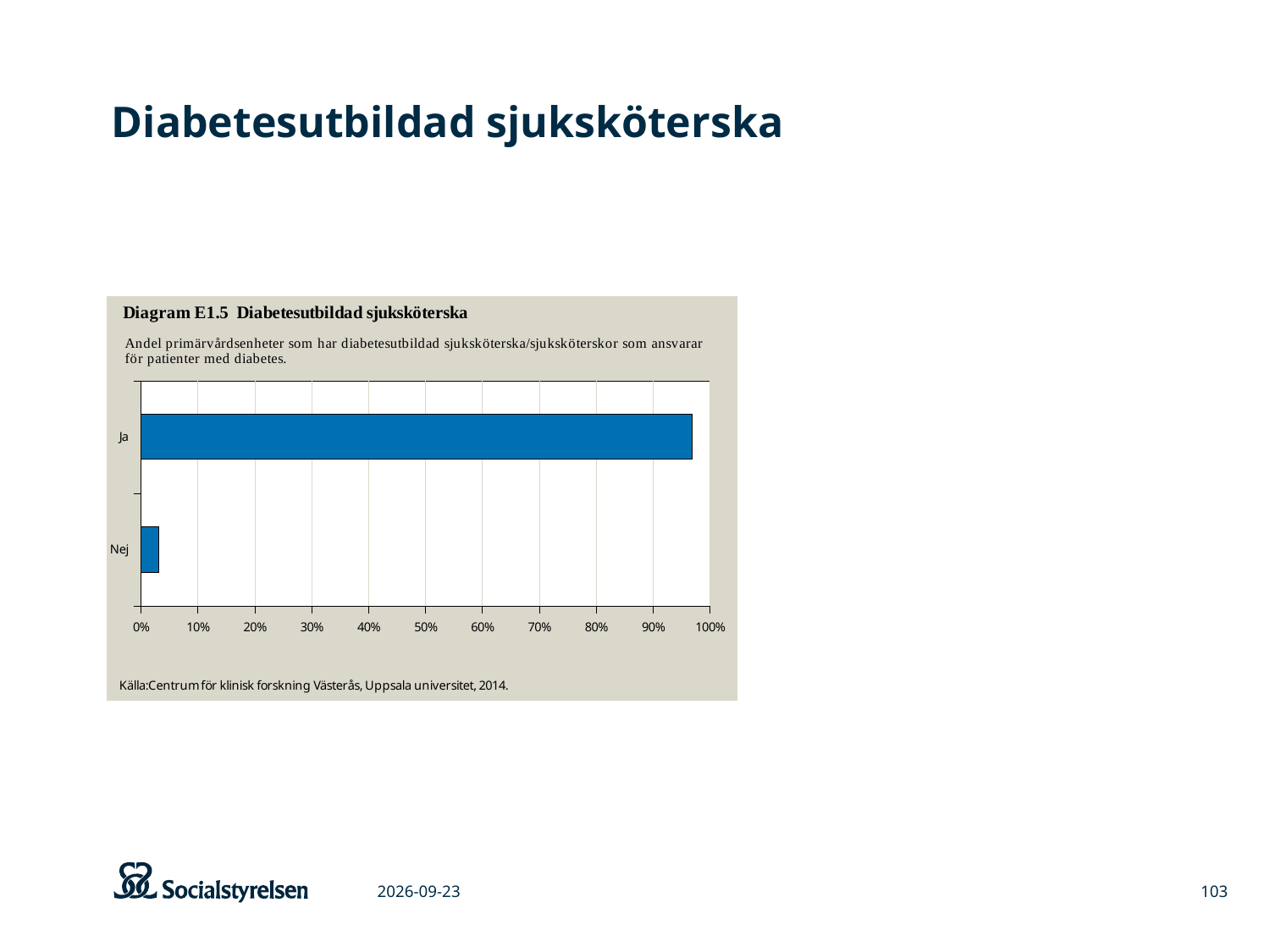
Which is larger, the value for Ja or the value for Nej? Ja How many categories are plotted in the chart? 2 Which category has the lowest value in the chart? Nej What kind of chart is shown in Diagram E1.5? bar chart Is the value for Ja greater or less than 90%? greater Which category has the highest value in the chart? Ja What is the highest value shown on the x axis of the chart? 100% What is the title of the diagram shown on the slide? Diagram E1.5 Diabetesutbildad sjuksköterska Is the value for Ja greater or less than 50%? greater Is the value for Nej greater or less than 10%? less